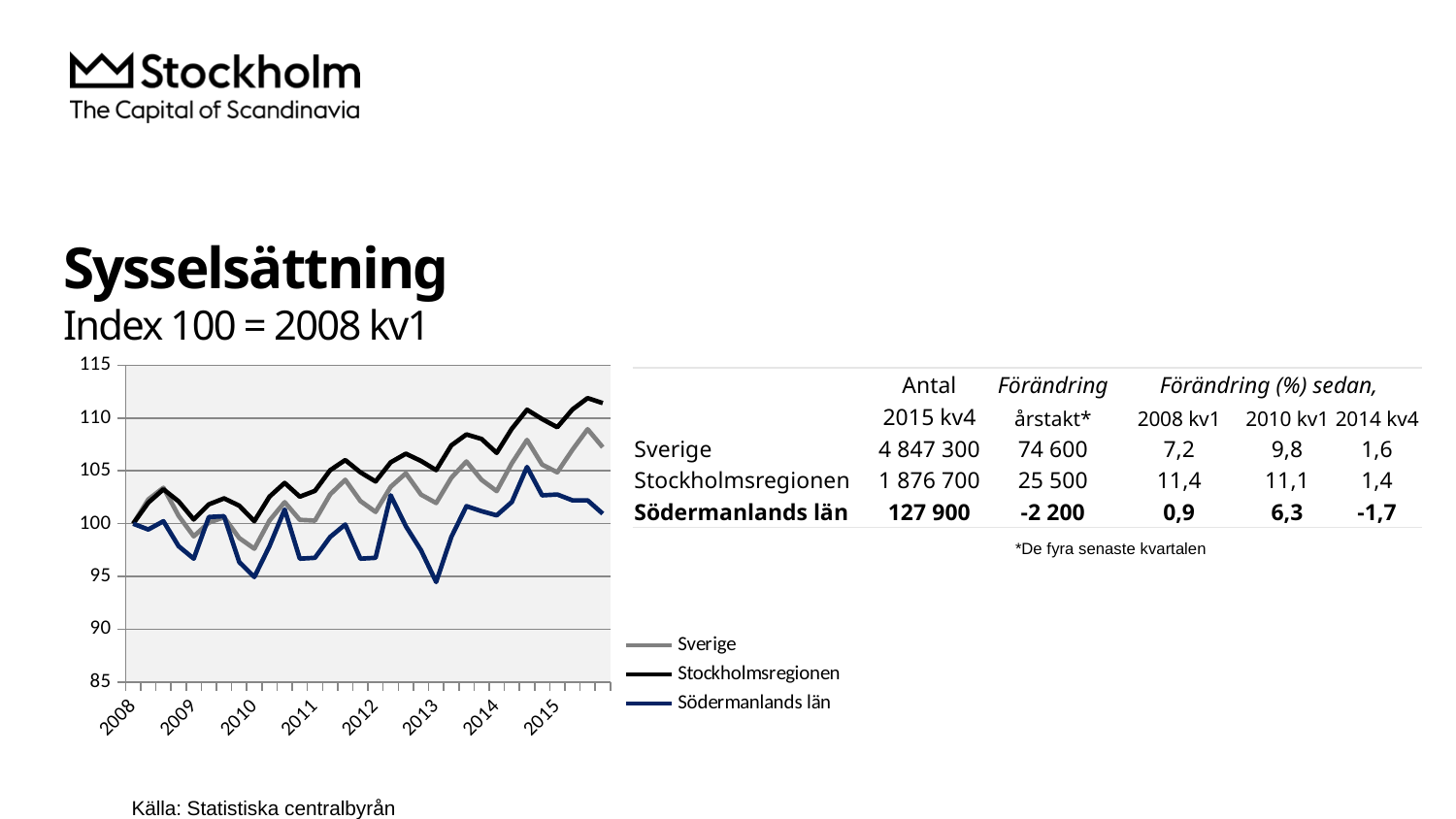
At the end of 2015, which is higher: the index for Stockholmsregionen or for Södermanlands län? Stockholmsregionen What is the title of the chart on the slide? Sysselsättning At the end of 2015, is the index for Stockholmsregionen greater or less than 110? greater At the end of 2015, is the index for Södermanlands län greater or less than 105? less At the end of 2015, is the index for Sverige greater or less than 105? greater What kind of chart is shown on the slide? line chart Does the index for Stockholmsregionen rise or fall overall from 2008 to 2015? rise How many series does the chart legend list? 3 Which series has the lowest index value at the end of 2015? Södermanlands län Which series has the highest index value at the end of 2015? Stockholmsregionen Which series is drawn in dark blue in the chart? Södermanlands län